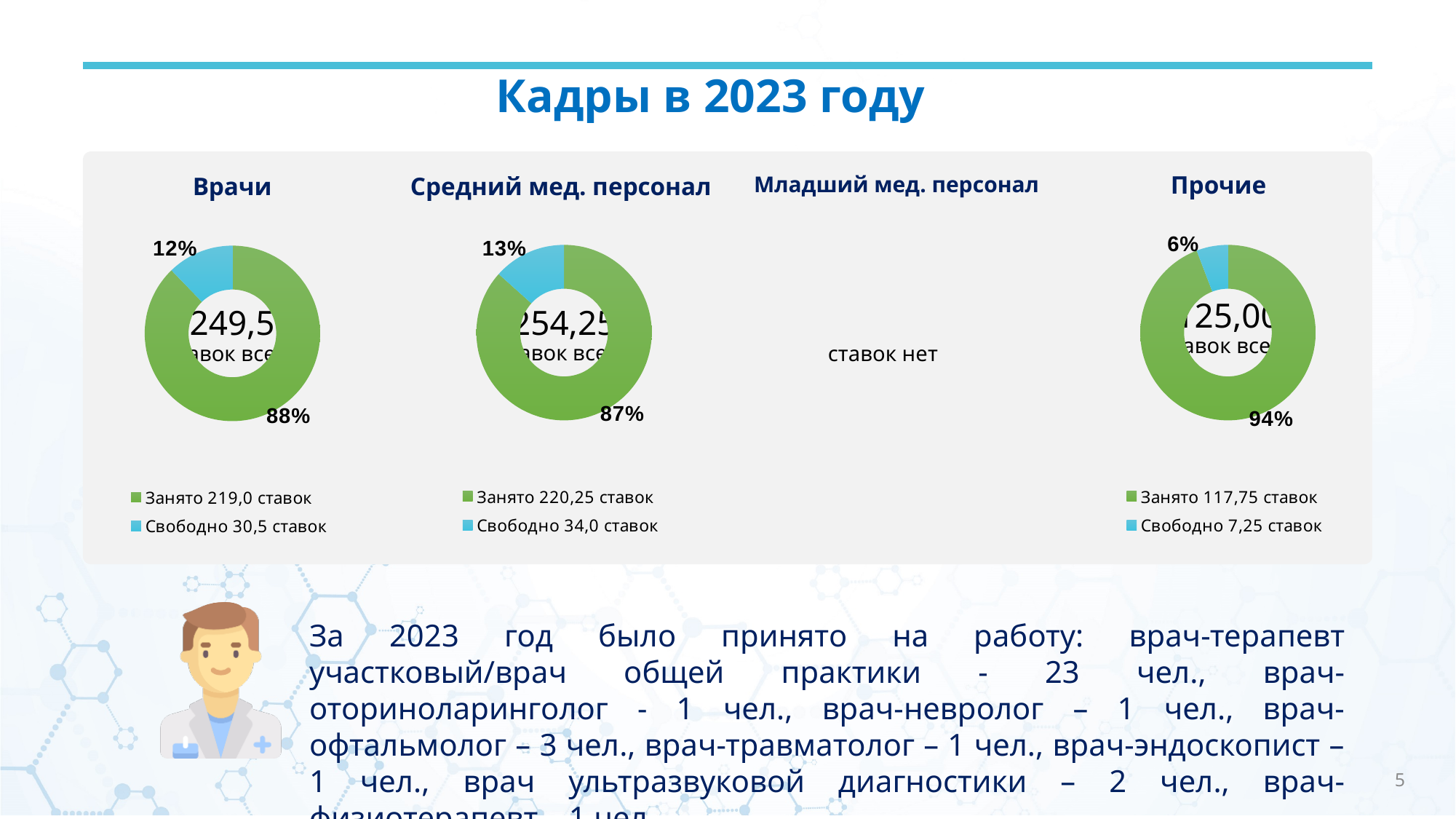
In the "Прочие" chart, what percentage is shown for the "Занято" slice? 94% In the "Врачи" chart, how many ставок does the legend give for "Занято"? 219,0 In the "Прочие" chart, which slice is larger, "Занято" or "Свободно"? Занято In the "Прочие" chart, how many ставок does the legend give for "Свободно"? 7,25 In the "Средний мед. персонал" chart, how many ставок does the legend give for "Свободно"? 34,0 In the "Средний мед. персонал" chart, what is the difference in percentage points between the "Занято" and "Свободно" slices? 74 In the "Средний мед. персонал" chart, what percentage is shown for the "Свободно" slice? 13% In the "Врачи" chart, what percentage is shown for the "Свободно" slice? 12% In the "Врачи" chart, what percentage of positions is shown for the "Занято" slice? 88% What kind of chart is used for "Врачи"? Donut (pie) chart How many entries does the legend of the "Средний мед. персонал" chart list? 2 Which of the three charts has the smallest "Свободно" share? Прочие